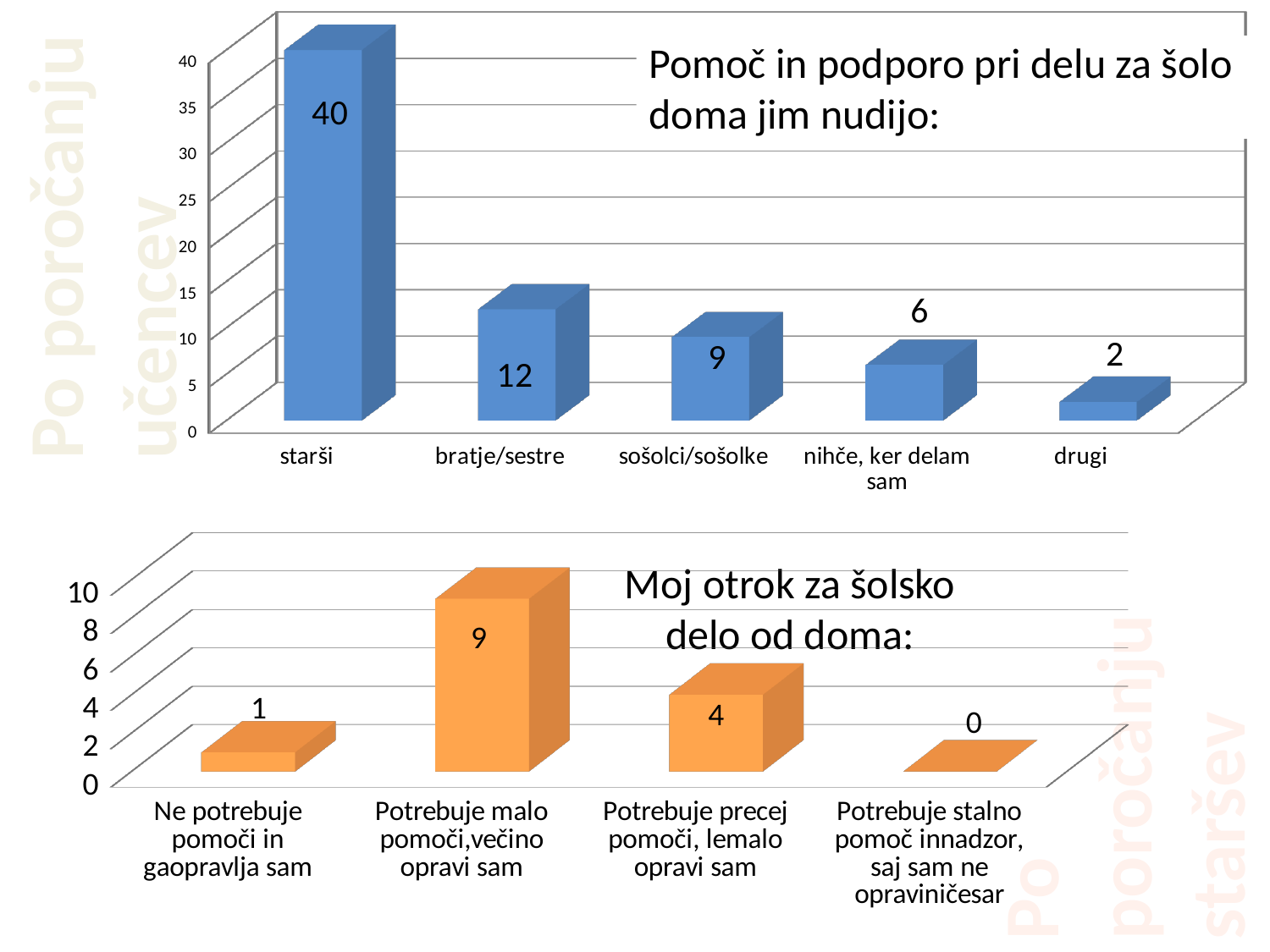
In the bottom chart 'Moj otrok za šolsko delo od doma:', which category has the highest value? Potrebuje malo pomoči,večino opravi sam In the top chart 'Pomoč in podporo pri delu za šolo doma jim nudijo:', what is the value for 'starši'? 40 In the top chart 'Pomoč in podporo pri delu za šolo doma jim nudijo:', what is the difference between the values for 'starši' and 'bratje/sestre'? 28 In the bottom chart 'Moj otrok za šolsko delo od doma:', what is the value for 'Potrebuje precej pomoči, lemalo opravi sam'? 4 What kind of chart is the bottom chart 'Moj otrok za šolsko delo od doma:'? bar chart In the top chart 'Pomoč in podporo pri delu za šolo doma jim nudijo:', how many categories are shown? 5 In the top chart 'Pomoč in podporo pri delu za šolo doma jim nudijo:', do the values rise or fall from left to right? fall In the bottom chart 'Moj otrok za šolsko delo od doma:', what is the value for 'Potrebuje stalno pomoč innadzor, saj sam ne opraviničesar'? 0 In the top chart 'Pomoč in podporo pri delu za šolo doma jim nudijo:', which category has the lowest value? drugi In the bottom chart 'Moj otrok za šolsko delo od doma:', what is the total of all the values shown? 14 In the top chart 'Pomoč in podporo pri delu za šolo doma jim nudijo:', what is the value for 'sošolci/sošolke'? 9 In the bottom chart 'Moj otrok za šolsko delo od doma:', which is larger: the value for 'Ne potrebuje pomoči in gaopravlja sam' or 'Potrebuje precej pomoči, lemalo opravi sam'? Potrebuje precej pomoči, lemalo opravi sam